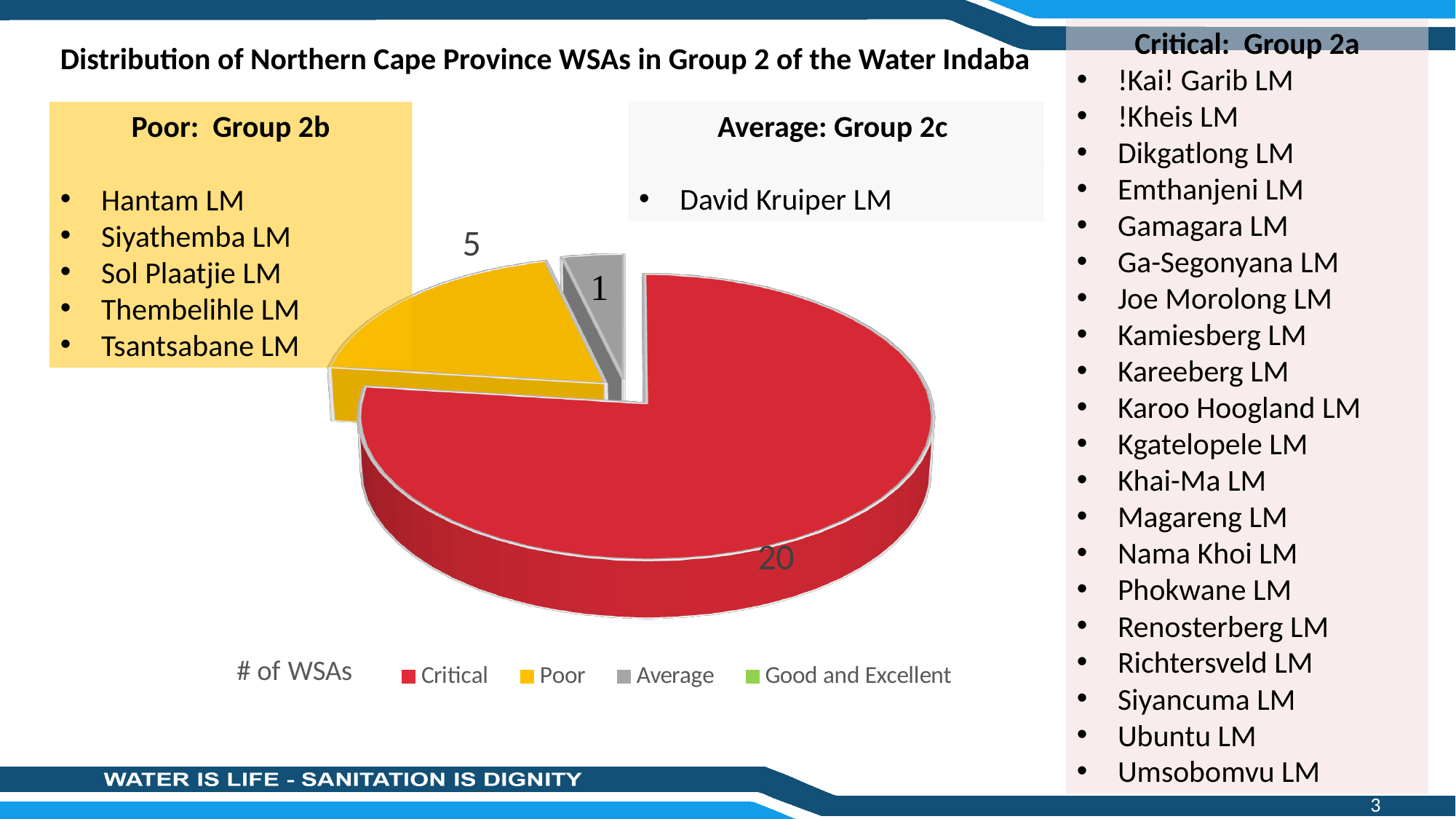
Which labelled slice of the pie is the smallest? Average How many entries does the chart legend list? 4 What is the difference between the Critical and Poor values? 15 What is the title shown for the pie chart? # of WSAs What is the number of WSAs in the Critical category? 20 What type of chart is shown on the slide? pie chart What is the number of WSAs in the Average category? 1 Which is larger, the Poor value or the Average value? Poor What is the number of WSAs in the Poor category? 5 What is the difference between the Poor and Average values? 4 Which category has the largest slice of the pie? Critical What colour is the Critical slice of the pie? red